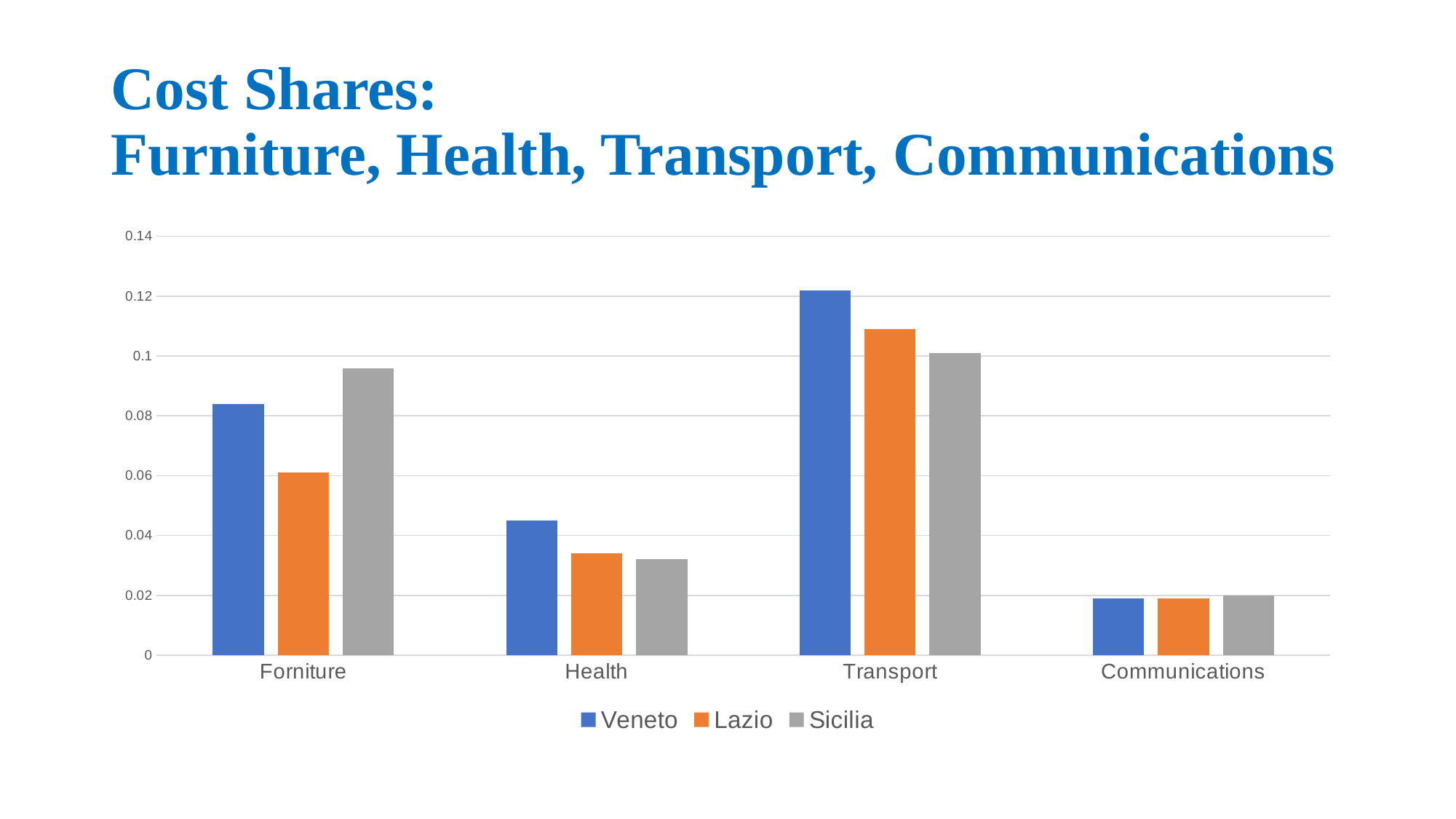
How many series does the legend list? 3 What kind of chart is shown on the slide? bar chart Is the value for Veneto in Transport greater or less than 0.1? greater In the Health category, which is larger: Veneto or Lazio? Veneto Is the value for Sicilia in Health greater or less than 0.04? less Which category has the lowest value for Lazio? Communications How many categories are shown on the x axis? 4 Which colour represents Lazio in the legend? orange Which region has the lowest value in the Forniture category? Lazio Is the value for Lazio in Forniture greater or less than 0.08? less Which category has the highest value for Veneto? Transport Which region has the highest value in the Forniture category? Sicilia